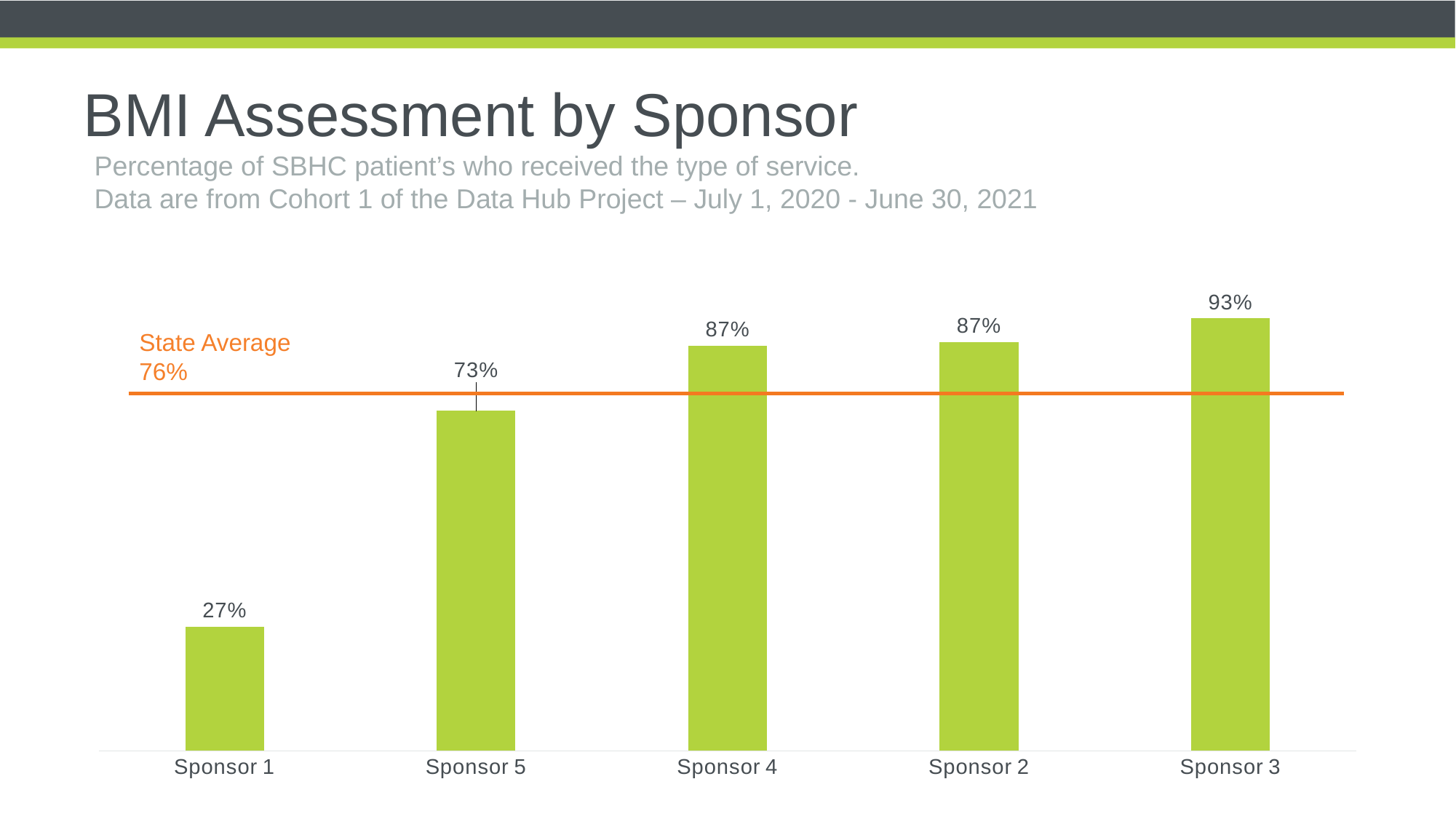
What kind of chart is shown on the slide? Bar chart What is the value for Sponsor 3? 93% How many sponsors are shown in the chart? 5 Which sponsor has the lowest value? Sponsor 1 What is the difference between the values for Sponsor 4 and Sponsor 5? 14% What is the value for Sponsor 1? 27% Which sponsor has the highest value? Sponsor 3 How many sponsors have a value above the State Average line? 3 What is the value for Sponsor 5? 73% Which is larger, the value for Sponsor 5 or the value for Sponsor 2? Sponsor 2 What is the State Average shown on the chart? 76% What is the difference between the values for Sponsor 3 and Sponsor 1? 66%